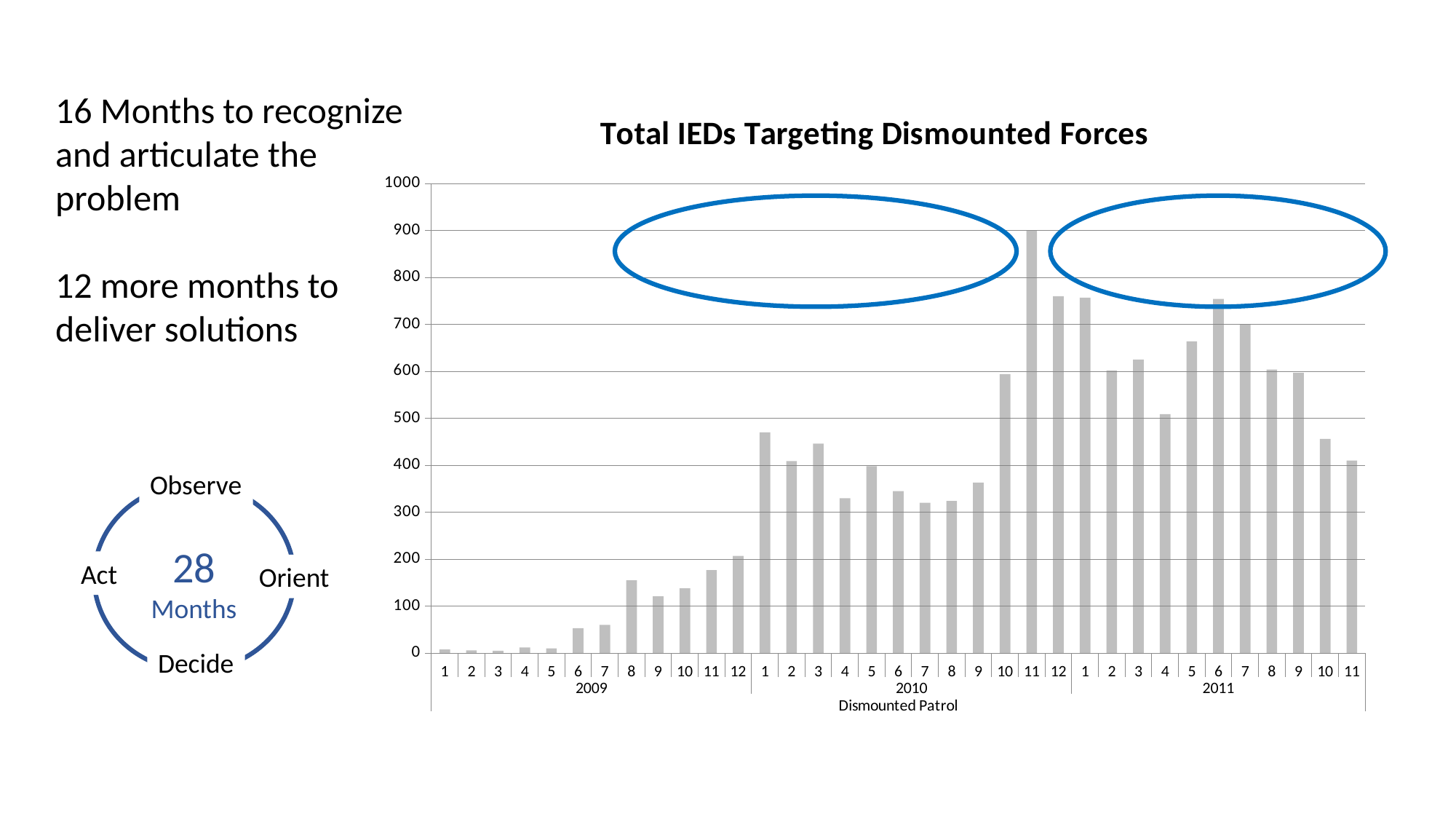
Is the value for month 11 of 2010 greater or less than 800? greater How many monthly bars are plotted in the chart? 35 Which years are shown along the x axis of the chart? 2009, 2010, 2011 Is the value for month 5 of 2011 greater or less than 600? greater What is the title of the chart? Total IEDs Targeting Dismounted Forces Which month has the highest value in the chart? Month 11 of 2010 What kind of chart is shown on the slide? bar chart Which is larger, the value for month 11 of 2010 or month 12 of 2010? Month 11 of 2010 Is the value for month 11 of 2011 greater or less than 500? less Do the values generally rise or fall across the months of 2009? rise Which is larger, the value for month 12 of 2009 or month 1 of 2010? Month 1 of 2010